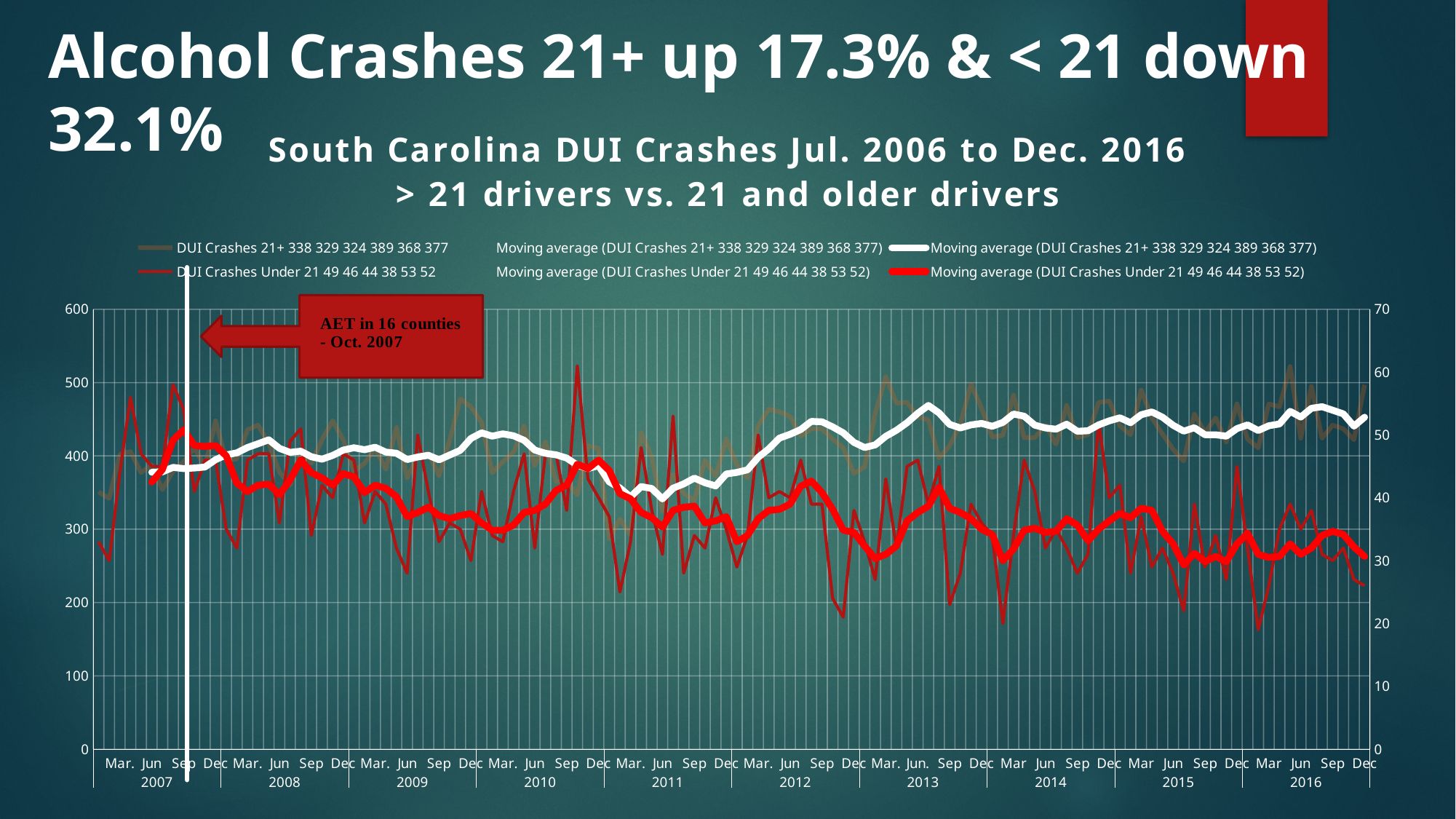
How many year labels appear along the x axis? 10 Is the white moving average line for DUI Crashes 21+ at the end of 2016 greater or less than 400 on the left axis? greater Does the thick red moving average line for DUI Crashes Under 21 rise or fall from 2008 to 2016 overall? Fall What kind of chart is shown on the slide? Line chart What is the title of the chart? South Carolina DUI Crashes Jul. 2006 to Dec. 2016 > 21 drivers vs. 21 and older drivers What is the highest value shown on the left vertical axis? 600 What is the highest value shown on the right vertical axis? 70 Is the white moving average line for DUI Crashes 21+ around mid-2011 greater or less than 400 on the left axis? less Is the thick red moving average line for DUI Crashes Under 21 at the end of 2016 greater or less than 40 on the right axis? less What does the red annotation box on the chart say? AET in 16 counties - Oct. 2007 How many series does the chart legend list? 6 Does the white moving average line for DUI Crashes 21+ rise or fall between mid-2011 and mid-2013? Rise